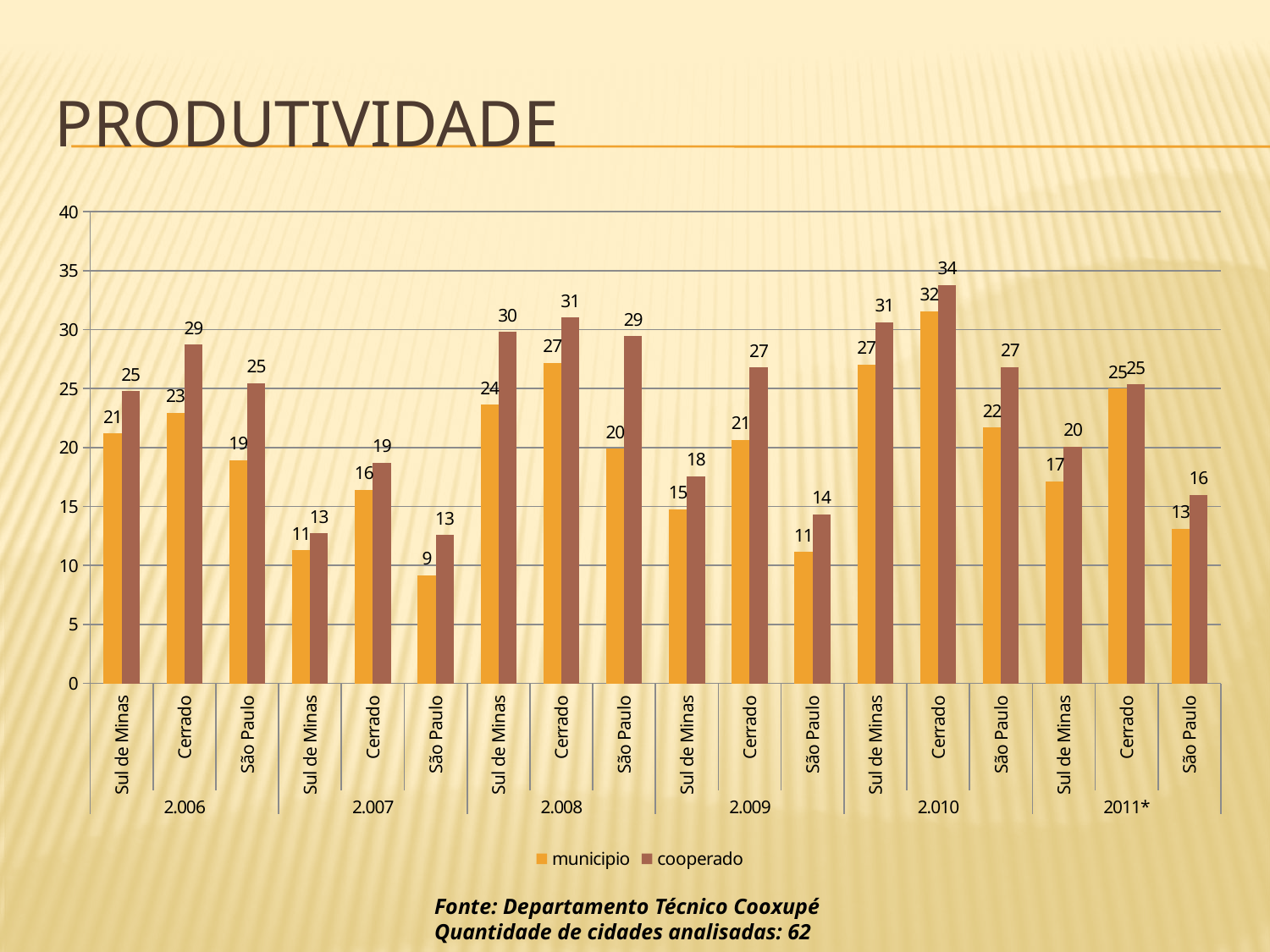
How many series does the legend list? 2 What is the municipio value for Sul de Minas in 2.007? 11 Which is larger, the municipio value for Cerrado in 2.008 or the municipio value for Cerrado in 2.009? Cerrado in 2.008 What is the title of the slide? PRODUTIVIDADE How many bars are plotted for the municipio series? 18 Which category has the highest cooperado value? Cerrado in 2.010 Which category has the lowest municipio value? São Paulo in 2.007 What is the cooperado value for São Paulo in 2.008? 29 Is the cooperado value for Sul de Minas in 2.010 greater or less than 30? greater What kind of chart is shown on the slide? Bar chart What is the difference between the cooperado and municipio values for São Paulo in 2.008? 9 What is the municipio value for Cerrado in 2.010? 32